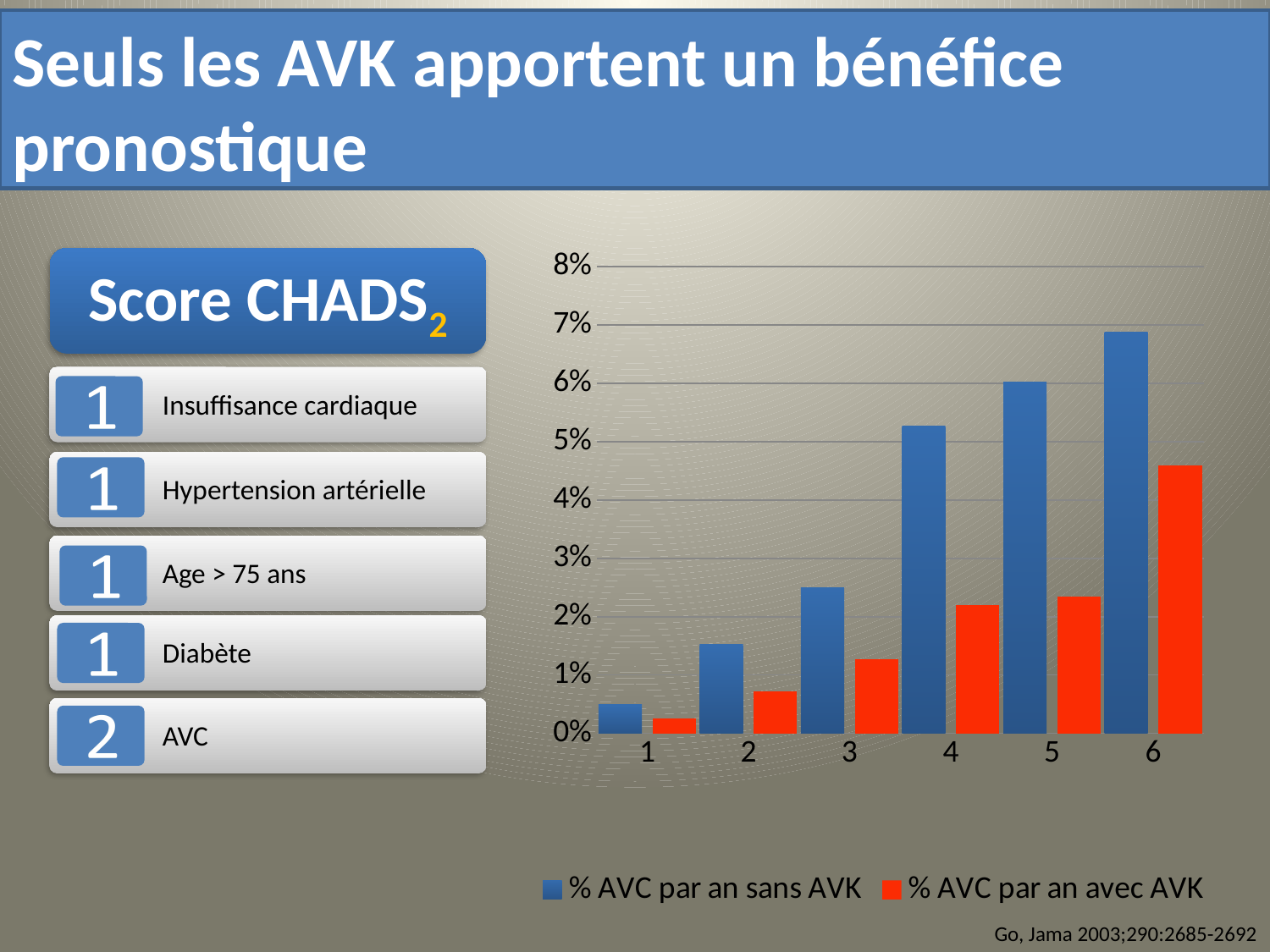
Is the value for '% AVC par an sans AVK' at score 2 greater or less than 2%? less Which colour represents '% AVC par an avec AVK' in the chart? red Which score category has the lowest value for '% AVC par an avec AVK'? 1 Do the values for '% AVC par an sans AVK' rise or fall as the score increases from 1 to 6? rise What kind of chart is shown on the slide? bar chart How many series does the chart legend list? 2 At score 4, which series has the larger value: '% AVC par an sans AVK' or '% AVC par an avec AVK'? % AVC par an sans AVK Which score category has the highest value for '% AVC par an sans AVK'? 6 Is the value for '% AVC par an avec AVK' at score 6 greater or less than 4%? greater How many score categories are shown on the x axis of the chart? 6 Is the value for '% AVC par an sans AVK' at score 6 greater or less than 6%? greater